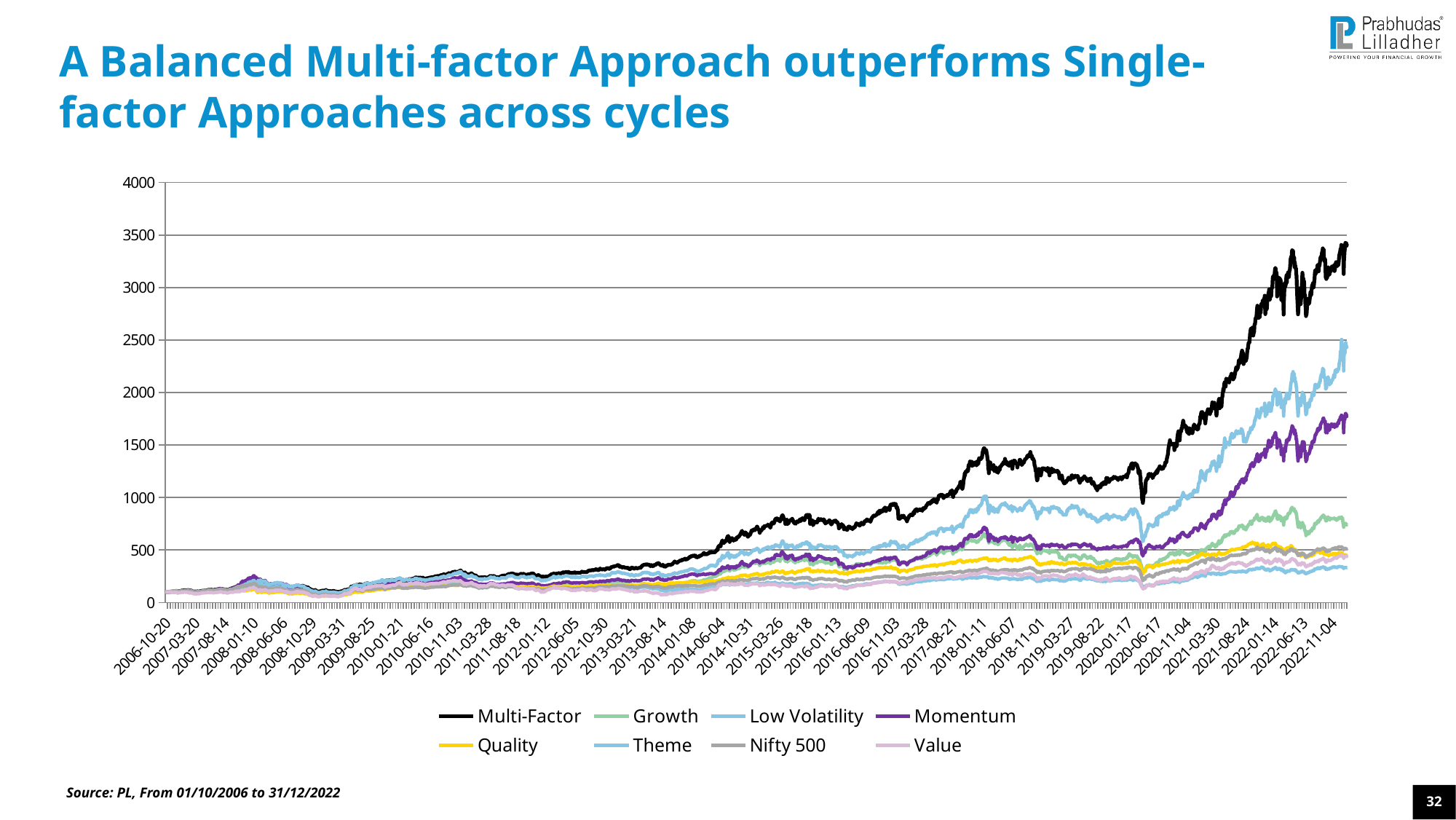
At the end of the period, which is larger: Low Volatility or Momentum? Low Volatility How many series does the legend list? 8 What kind of chart is shown on the slide? line chart Which series has the highest value at the end of the period (2022-11-04)? Multi-Factor Which series has the lowest value at the end of the period (2022-11-04)? Theme What colour is the Multi-Factor line in the legend? black Does the Multi-Factor series rise or fall overall from 2006 to 2022? rise Is the value of the Momentum series at the end of the period greater or less than 1500? greater Is the value of the Multi-Factor series at the end of the period greater or less than 3000? greater Is the value of the Low Volatility series at the end of the period greater or less than 2000? greater What is the title of the slide? A Balanced Multi-factor Approach outperforms Single-factor Approaches across cycles